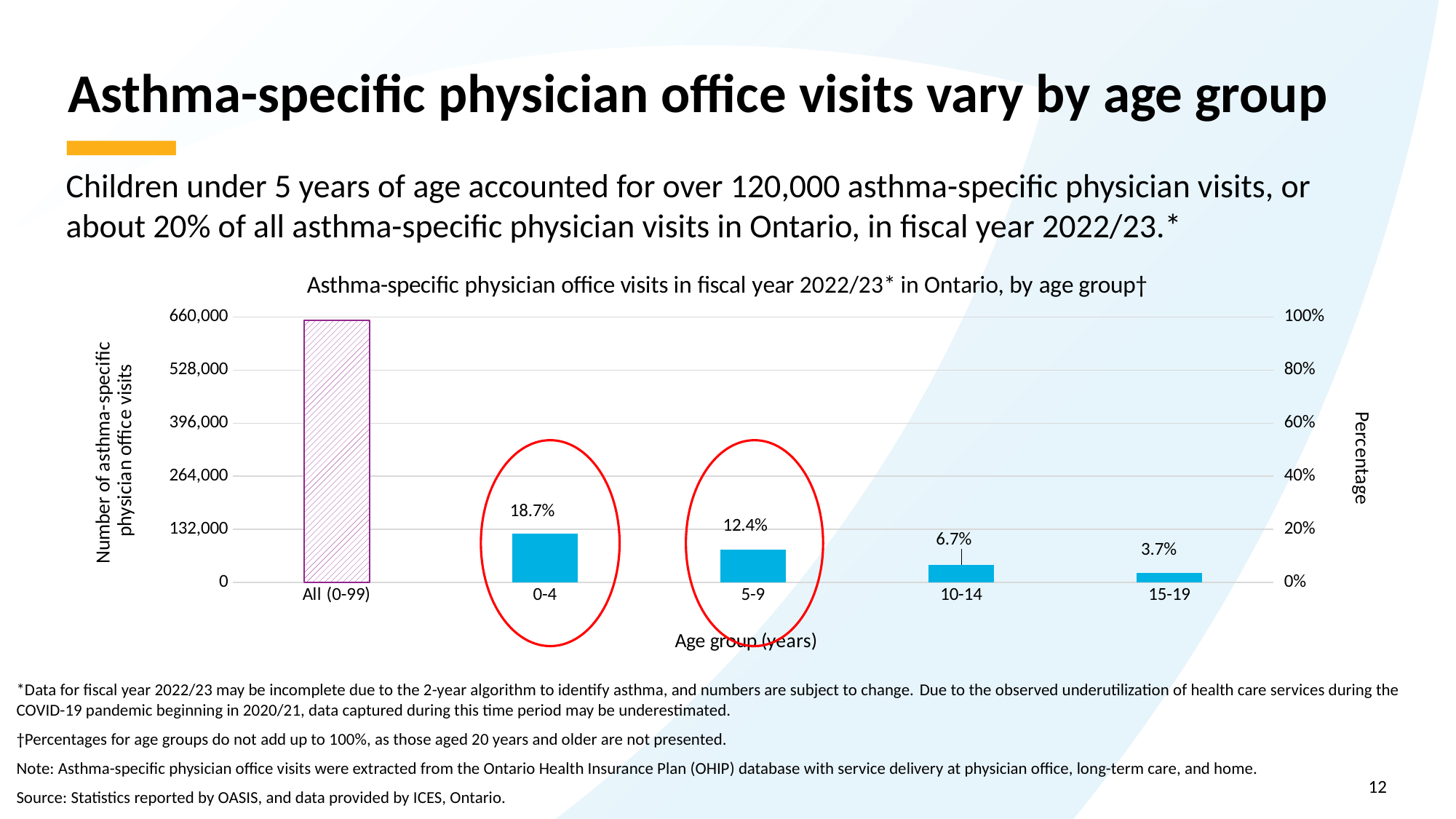
What is the difference in percentage between the 0-4 and 5-9 age groups? 6.3% Among the age groups with percentage labels, which has the highest percentage? 0-4 Which has a larger percentage, the 10-14 age group or the 15-19 age group? 10-14 What percentage is shown for the 5-9 age group? 12.4% Is the number of visits for the All (0-99) bar greater or less than 528,000? greater Among the age groups with percentage labels, which has the lowest percentage? 15-19 How many age group categories are shown on the x axis? 5 What percentage is shown for the 10-14 age group? 6.7% What percentage is shown for the 0-4 age group? 18.7% What percentage is shown for the 15-19 age group? 3.7% Do the percentages rise or fall from the 0-4 age group to the 15-19 age group? fall What kind of chart is shown on the slide? bar chart